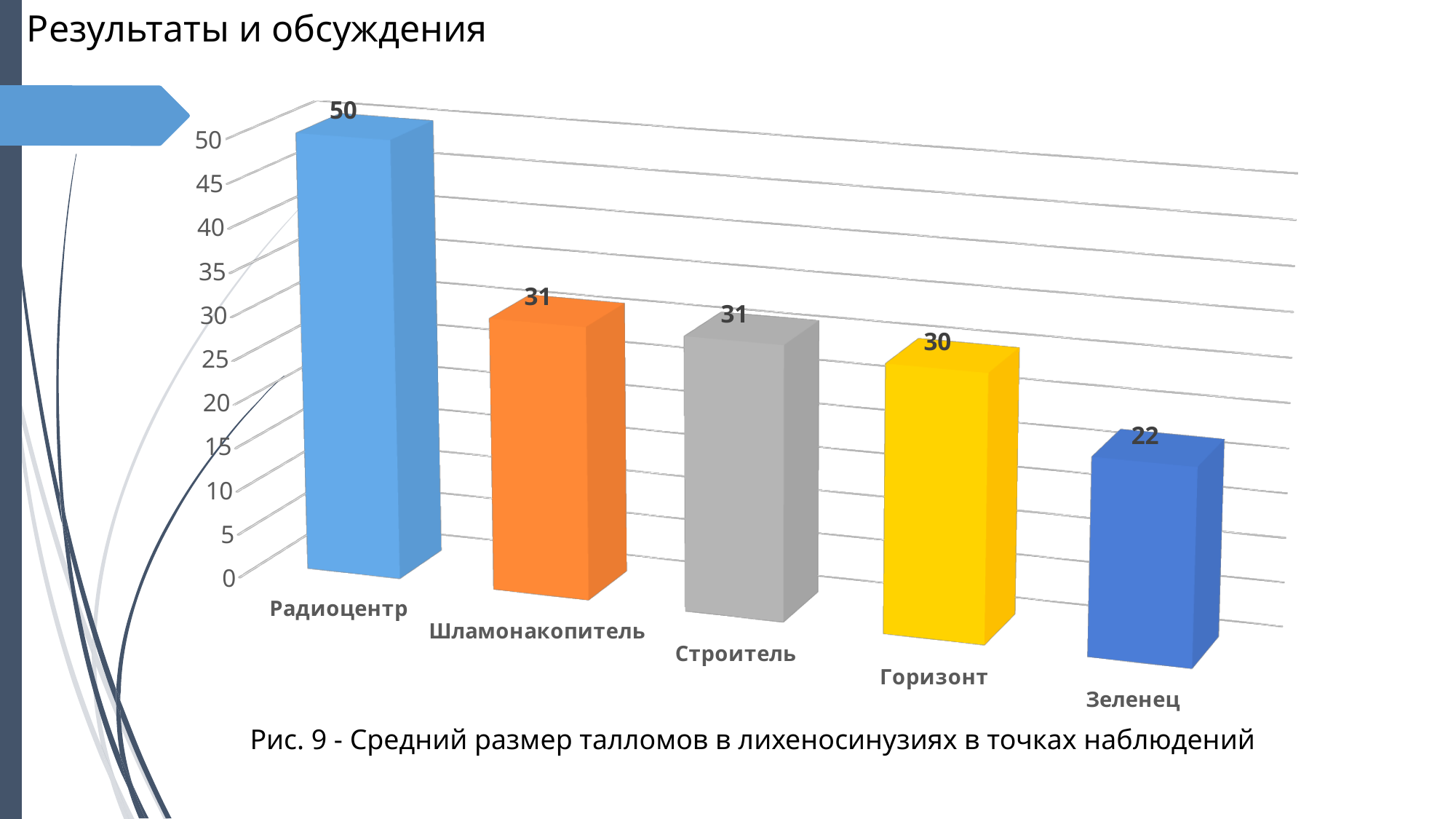
What kind of chart is shown on the slide? Bar chart Which category has the highest value? Радиоцентр Which category has the lowest value? Зеленец What is the value for Горизонт? 30 What is the caption of the figure below the chart? Рис. 9 - Средний размер талломов в лихеносинузиях в точках наблюдений What is the difference between the values for Строитель and Горизонт? 1 Which is larger, the value for Радиоцентр or the value for Строитель? Радиоцентр What is the value for Радиоцентр? 50 What is the difference between the values for Радиоцентр and Зеленец? 28 What is the value for Зеленец? 22 What is the value for Шламонакопитель? 31 How many categories are shown on the chart? 5